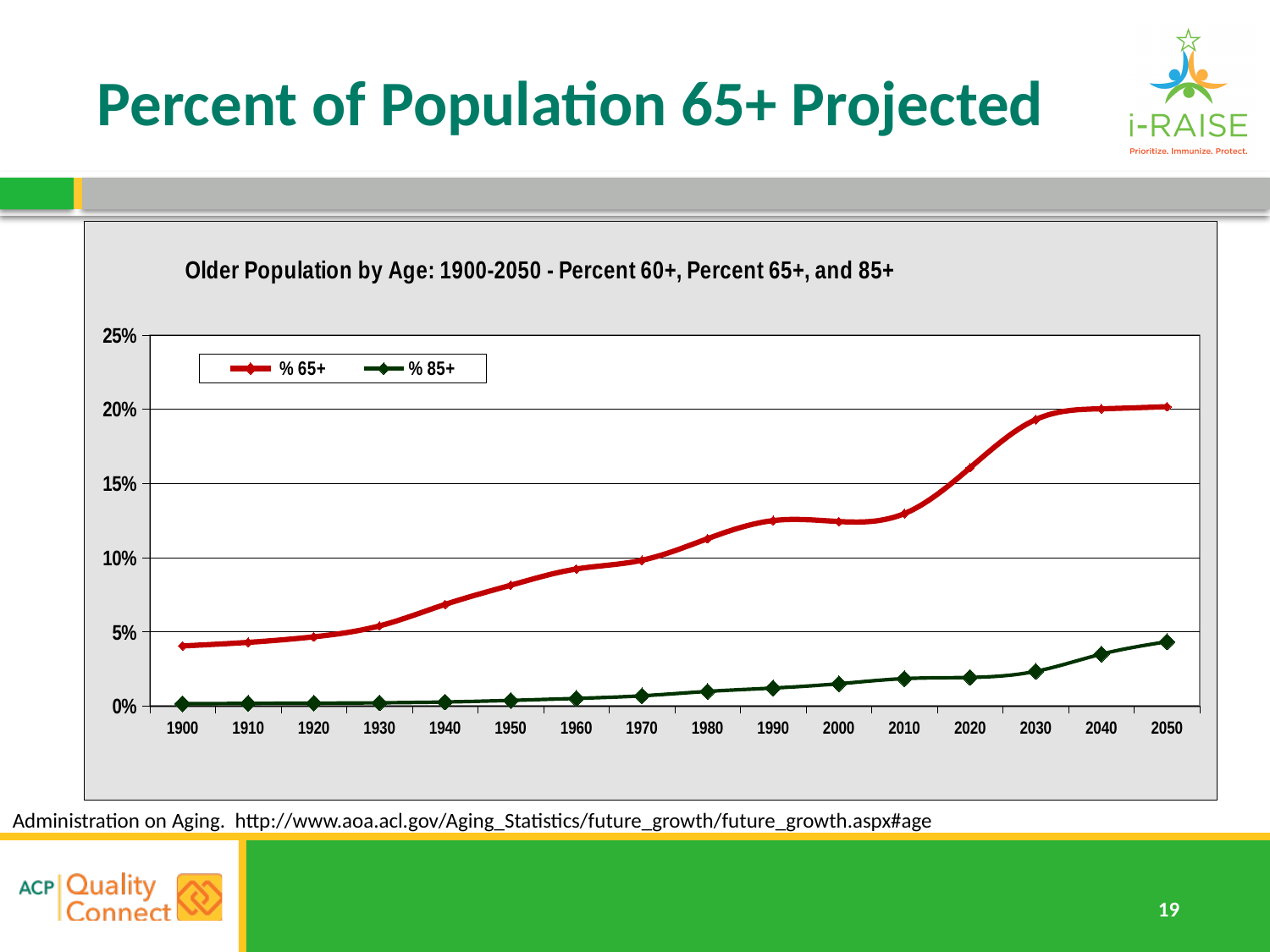
How many years are plotted along the x axis of the chart? 16 Is the value for % 85+ in 2050 greater or less than 5%? less In 2000, which series has the larger value, % 65+ or % 85+? % 65+ In which year does the % 85+ series reach its highest value? 2050 How many series does the chart legend list? 2 What kind of chart is shown on the slide? line chart Is the value for % 65+ in 1940 greater or less than 5%? greater Does the % 65+ series generally rise or fall from 1900 to 2050? rise What colour is the line for the % 65+ series? red Is the value for % 65+ in 2020 greater or less than 15%? greater